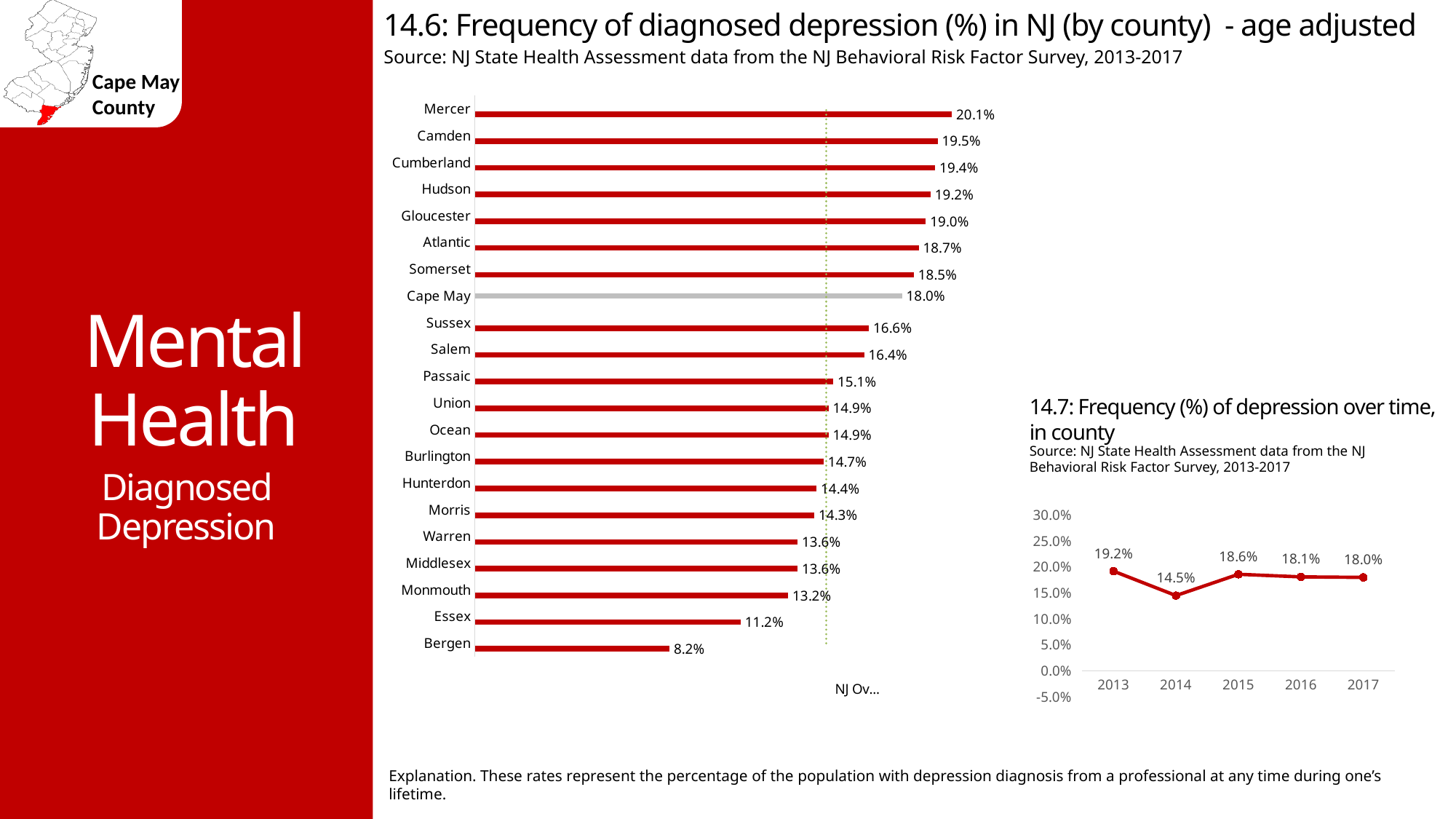
In chart 14.6, what is the difference between Mercer's value and Bergen's value? 11.9% What type of chart is chart 14.6? Bar chart In chart 14.6, which county has the highest frequency of diagnosed depression? Mercer In chart 14.7, what is the difference between the 2013 value and the 2017 value? 1.2% In chart 14.6, what is the value for Hunterdon? 14.4% In chart 14.7, how many years are plotted? 5 In chart 14.6, which county has the lowest frequency of diagnosed depression? Bergen In chart 14.6, how many counties are shown? 21 In chart 14.7, what is the frequency of depression in 2014? 14.5% In chart 14.7, which year has the lowest frequency of depression? 2014 In chart 14.6, what is the frequency of diagnosed depression for Cape May? 18.0% In chart 14.6, which county has a higher value, Camden or Essex? Camden